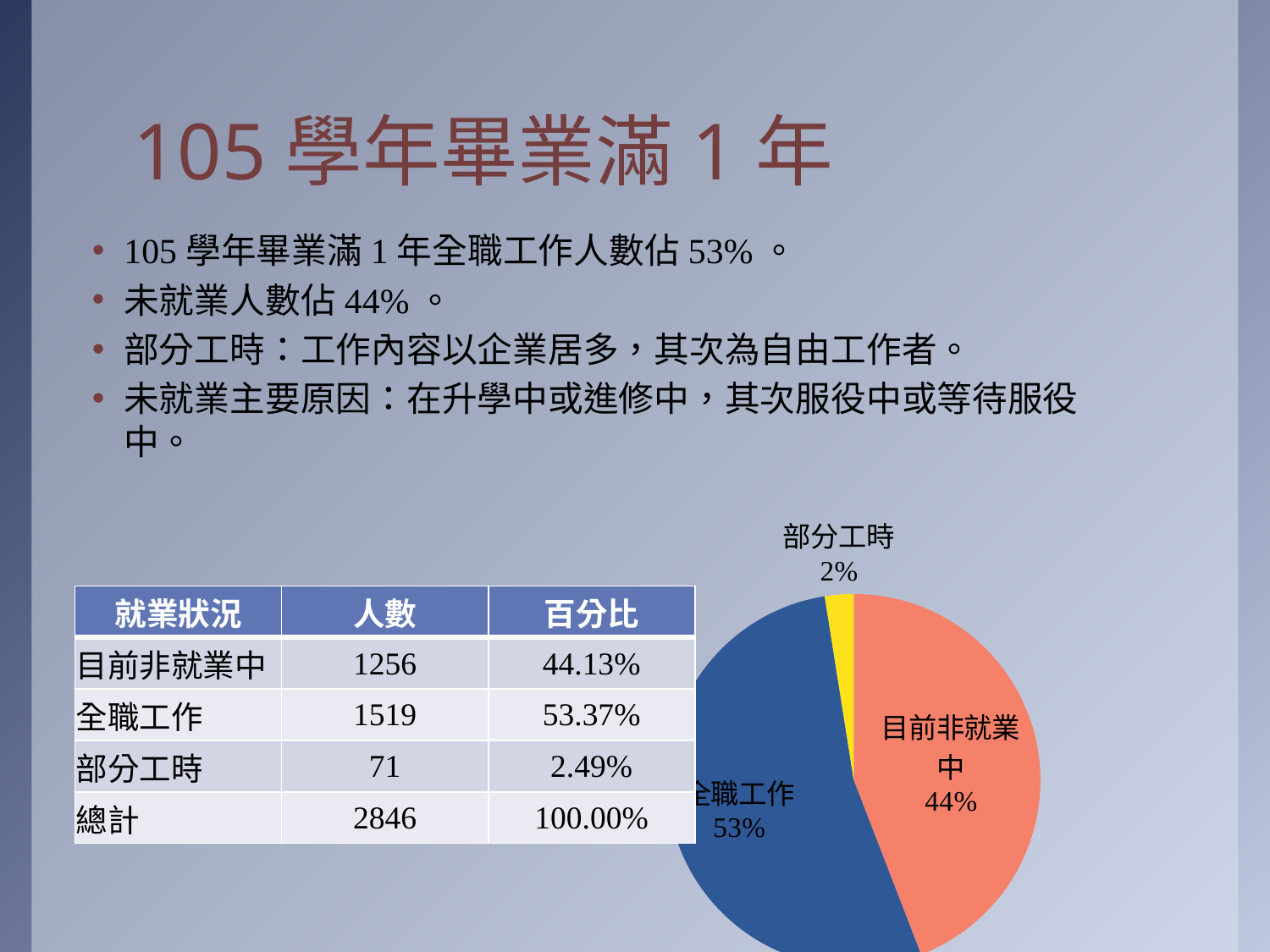
Which slice of the pie chart is the largest? 全職工作 In the pie chart, what is the difference in percentage points between 目前非就業中 and 部分工時? 42 In the pie chart, which is larger: 全職工作 or 目前非就業中? 全職工作 Which slice of the pie chart is the smallest? 部分工時 How many slices does the pie chart have? 3 What colour is the 部分工時 slice in the pie chart? yellow What kind of chart is shown on the slide? pie chart What share of the pie chart does 目前非就業中 represent? 44% In the pie chart, what is the difference in percentage points between 全職工作 and 目前非就業中? 9 What colour is the 全職工作 slice in the pie chart? blue What share of the pie chart does 部分工時 represent? 2% What share of the pie chart does 全職工作 represent? 53%